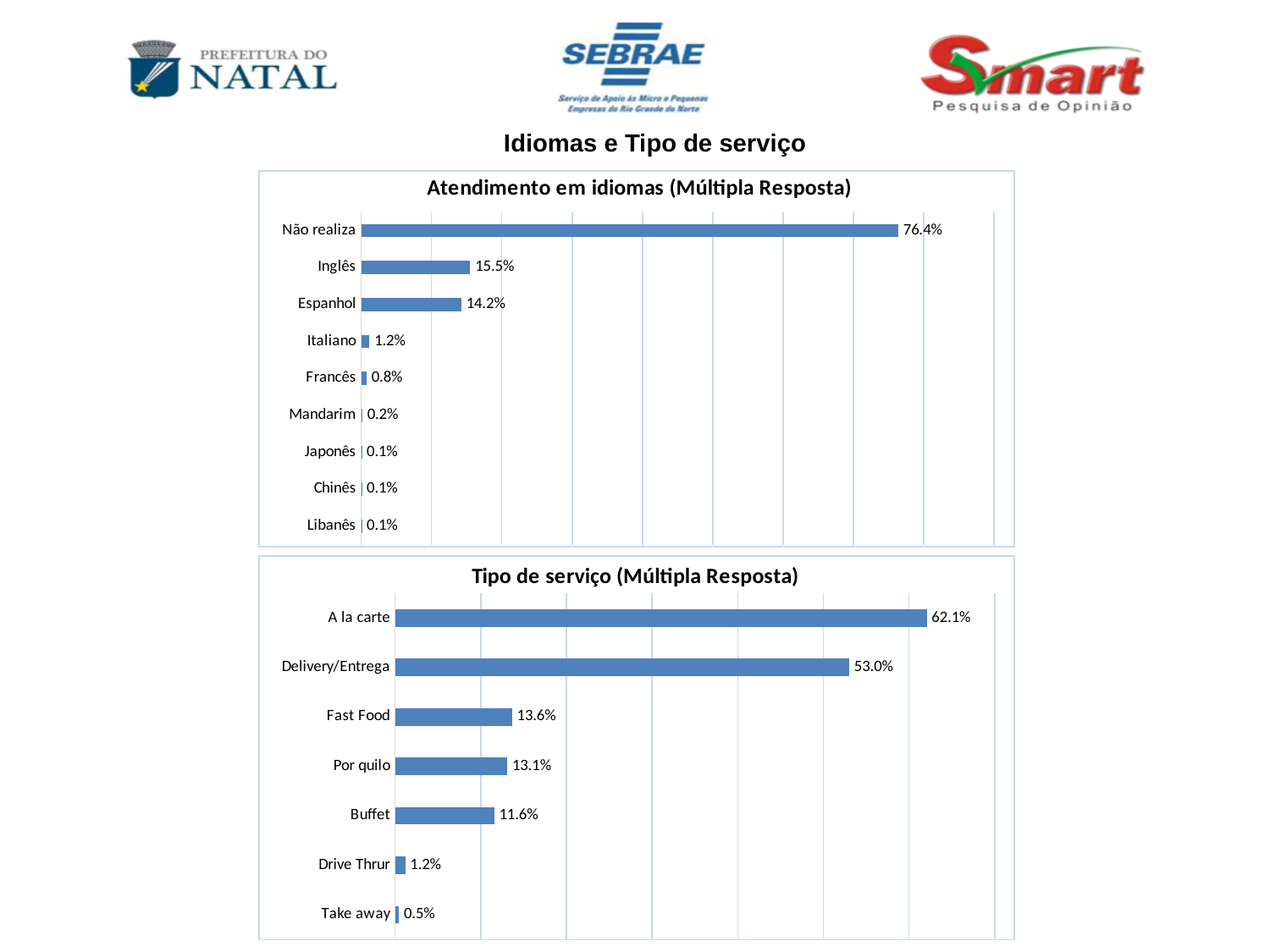
In the 'Atendimento em idiomas (Múltipla Resposta)' chart, what is the difference between Inglês and Espanhol? 1.3% In the 'Atendimento em idiomas (Múltipla Resposta)' chart, what is the value for Inglês? 15.5% In the 'Atendimento em idiomas (Múltipla Resposta)' chart, what is the value for Espanhol? 14.2% In the 'Atendimento em idiomas (Múltipla Resposta)' chart, how many categories are shown? 9 In the 'Tipo de serviço (Múltipla Resposta)' chart, which category has the lowest value? Take away In the 'Tipo de serviço (Múltipla Resposta)' chart, what is the value for Delivery/Entrega? 53.0% In the 'Tipo de serviço (Múltipla Resposta)' chart, what is the value for Buffet? 11.6% In the 'Tipo de serviço (Múltipla Resposta)' chart, how many categories are shown? 7 In the 'Atendimento em idiomas (Múltipla Resposta)' chart, which is larger, Italiano or Francês? Italiano What kind of chart is the 'Tipo de serviço (Múltipla Resposta)' chart? Bar chart In the 'Tipo de serviço (Múltipla Resposta)' chart, what is the difference between A la carte and Delivery/Entrega? 9.1% In the 'Atendimento em idiomas (Múltipla Resposta)' chart, which category has the highest value? Não realiza